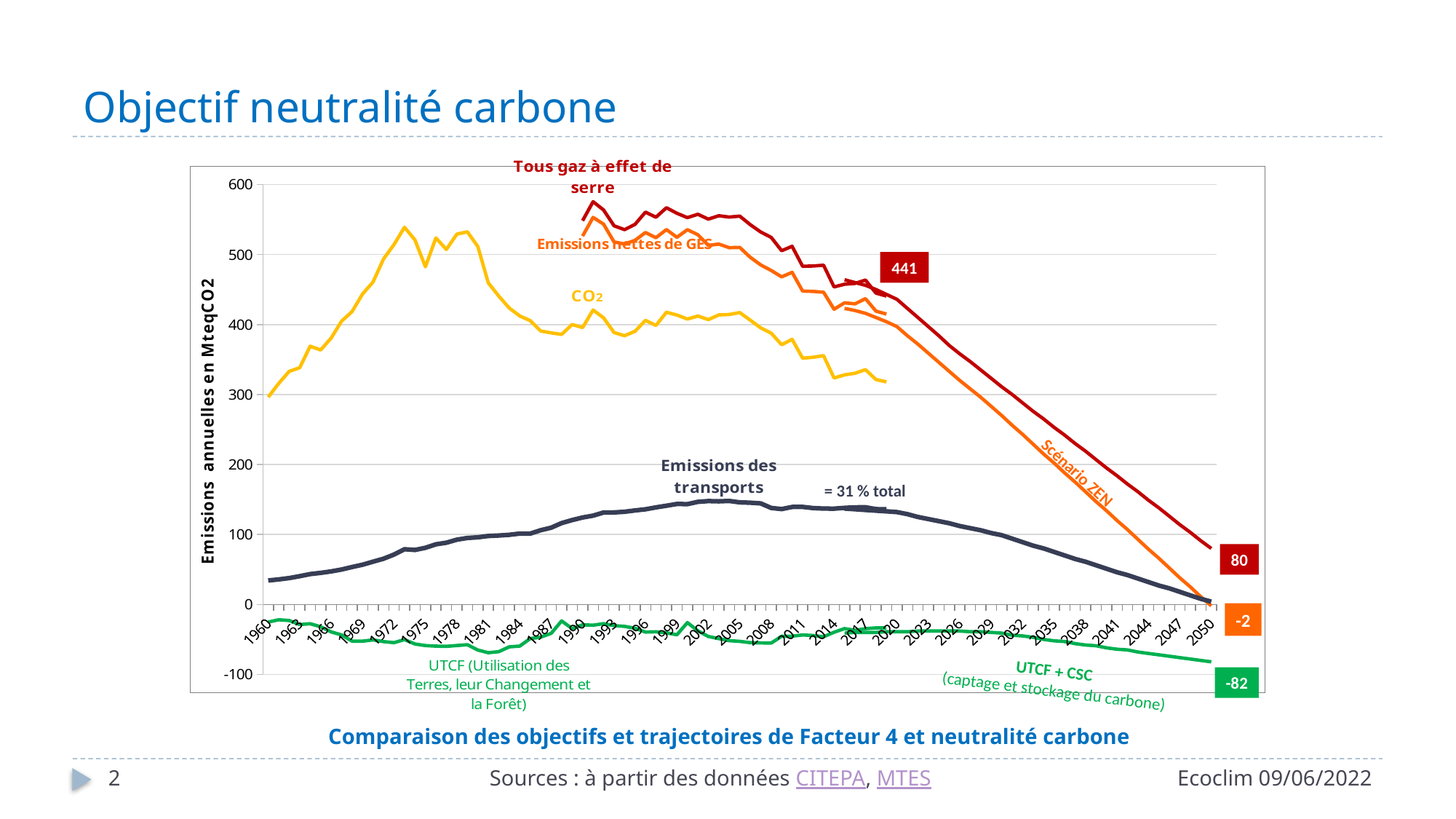
Does the 'Emissions des transports' line rise or fall between 2020 and 2050? fall What value is labelled at 2050 for the green 'UTCF + CSC' line? -82 What is the caption written below the chart? Comparaison des objectifs et trajectoires de Facteur 4 et neutralité carbone At 2050, which is higher: the 'Tous gaz à effet de serre' line or the 'Scénario ZEN' line? Tous gaz à effet de serre Is the peak value of the yellow CO2 line greater or less than 500? greater Is the value of 'Emissions des transports' in 1960 greater or less than 100? less According to the annotation, what share of total emissions do transport emissions represent? 31 % What value is labelled at 2050 for the dark red 'Tous gaz à effet de serre' line? 80 What value is labelled at 2050 for the orange 'Scénario ZEN' line? -2 What kind of chart is shown on the slide? line chart What value is shown in the dark red label near the 'Tous gaz à effet de serre' line around 2017–2020? 441 What is the difference between the 441 label and the 2050 value of 80 on the dark red line? 361